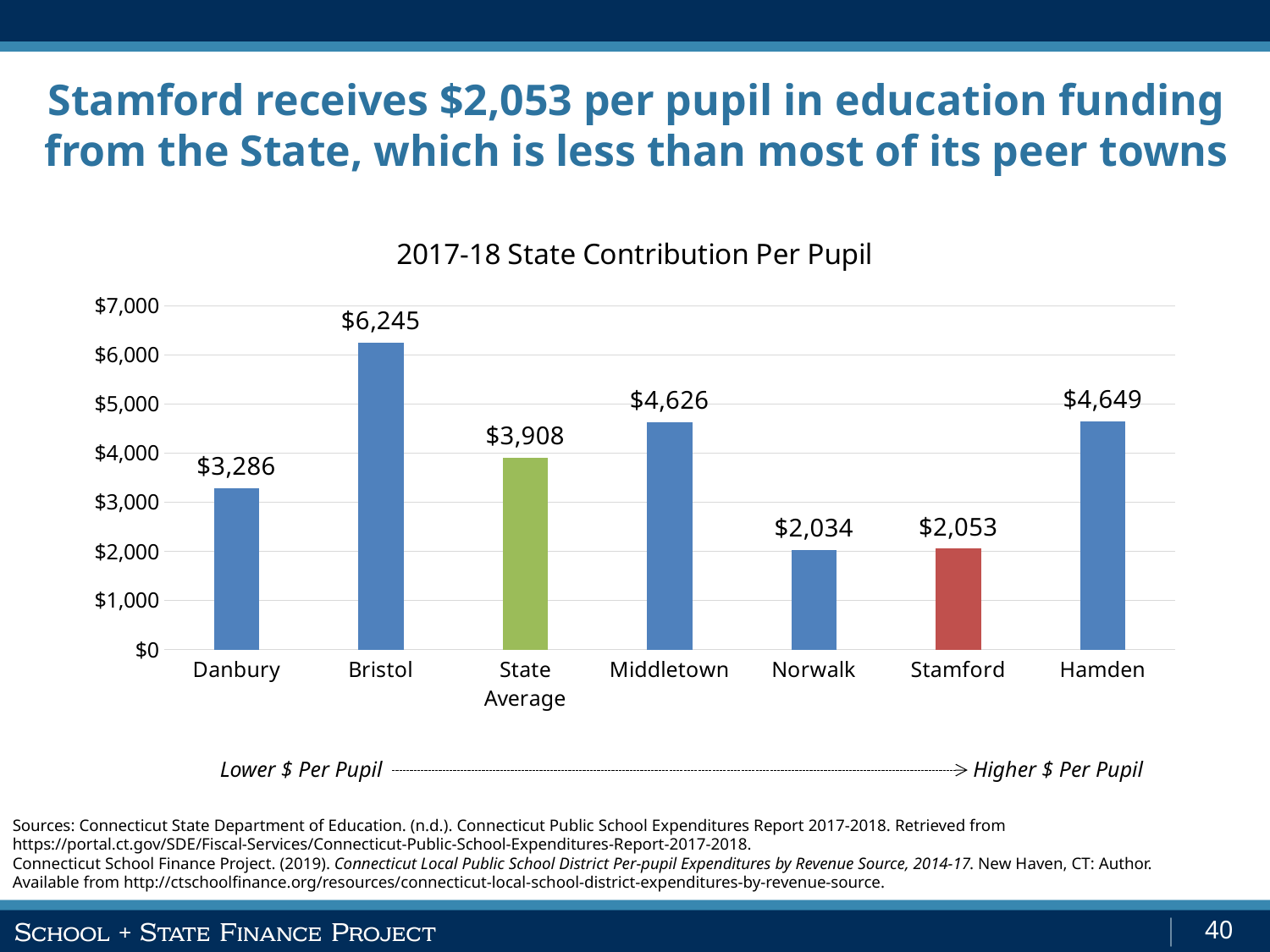
Is the value for Hamden greater or less than $4,000? greater What is the difference between the state contribution per pupil for Bristol and Stamford? $4,192 How much higher is the State Average than Stamford's state contribution per pupil? $1,855 Which receives more state contribution per pupil, Danbury or Middletown? Middletown What is the title of the chart? 2017-18 State Contribution Per Pupil What kind of chart is shown on the slide? Bar chart Which town has the highest state contribution per pupil? Bristol What is the state contribution per pupil for Stamford? $2,053 Which town has the lowest state contribution per pupil? Norwalk What is the 2017-18 state contribution per pupil for Bristol? $6,245 What is the value shown for the State Average? $3,908 How many categories are shown on the x axis of the chart? 7